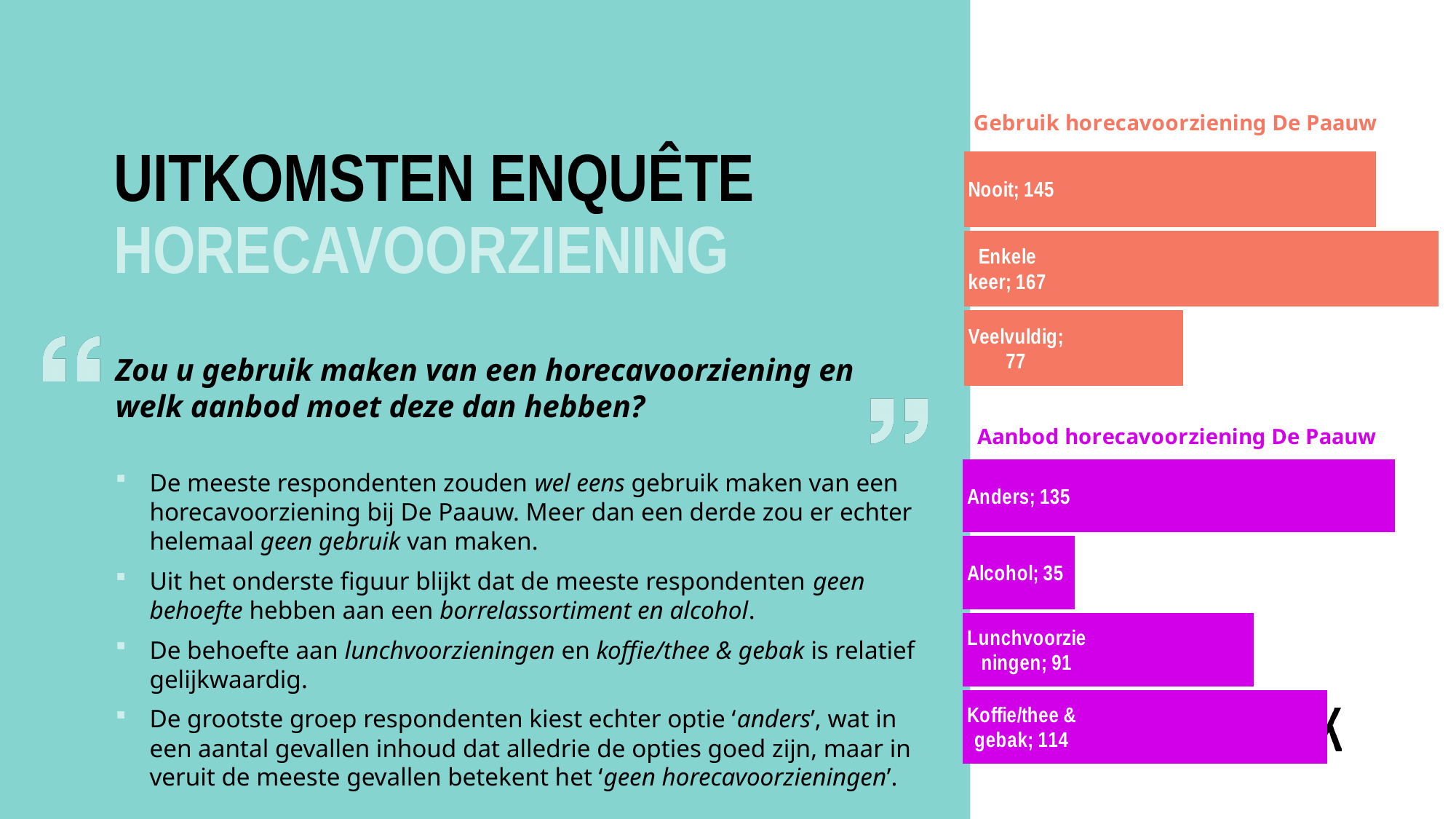
In the 'Aanbod horecavoorziening De Paauw' chart, what is the difference between 'Anders' and 'Alcohol'? 100 What type of chart is the 'Aanbod horecavoorziening De Paauw' chart? Bar chart In the 'Aanbod horecavoorziening De Paauw' chart, what is the value for 'Alcohol'? 35 In the 'Gebruik horecavoorziening De Paauw' chart, which category has the highest value? Enkele keer In the 'Aanbod horecavoorziening De Paauw' chart, what is the value for 'Koffie/thee & gebak'? 114 In the 'Gebruik horecavoorziening De Paauw' chart, what is the value for 'Enkele keer'? 167 In the 'Gebruik horecavoorziening De Paauw' chart, how many categories are shown? 3 In the 'Gebruik horecavoorziening De Paauw' chart, what is the value for 'Nooit'? 145 In the 'Aanbod horecavoorziening De Paauw' chart, which is larger: 'Lunchvoorzieningen' or 'Koffie/thee & gebak'? Koffie/thee & gebak In the 'Gebruik horecavoorziening De Paauw' chart, what is the difference between 'Enkele keer' and 'Nooit'? 22 In the 'Aanbod horecavoorziening De Paauw' chart, which category has the highest value? Anders In the 'Gebruik horecavoorziening De Paauw' chart, which category has the lowest value? Veelvuldig